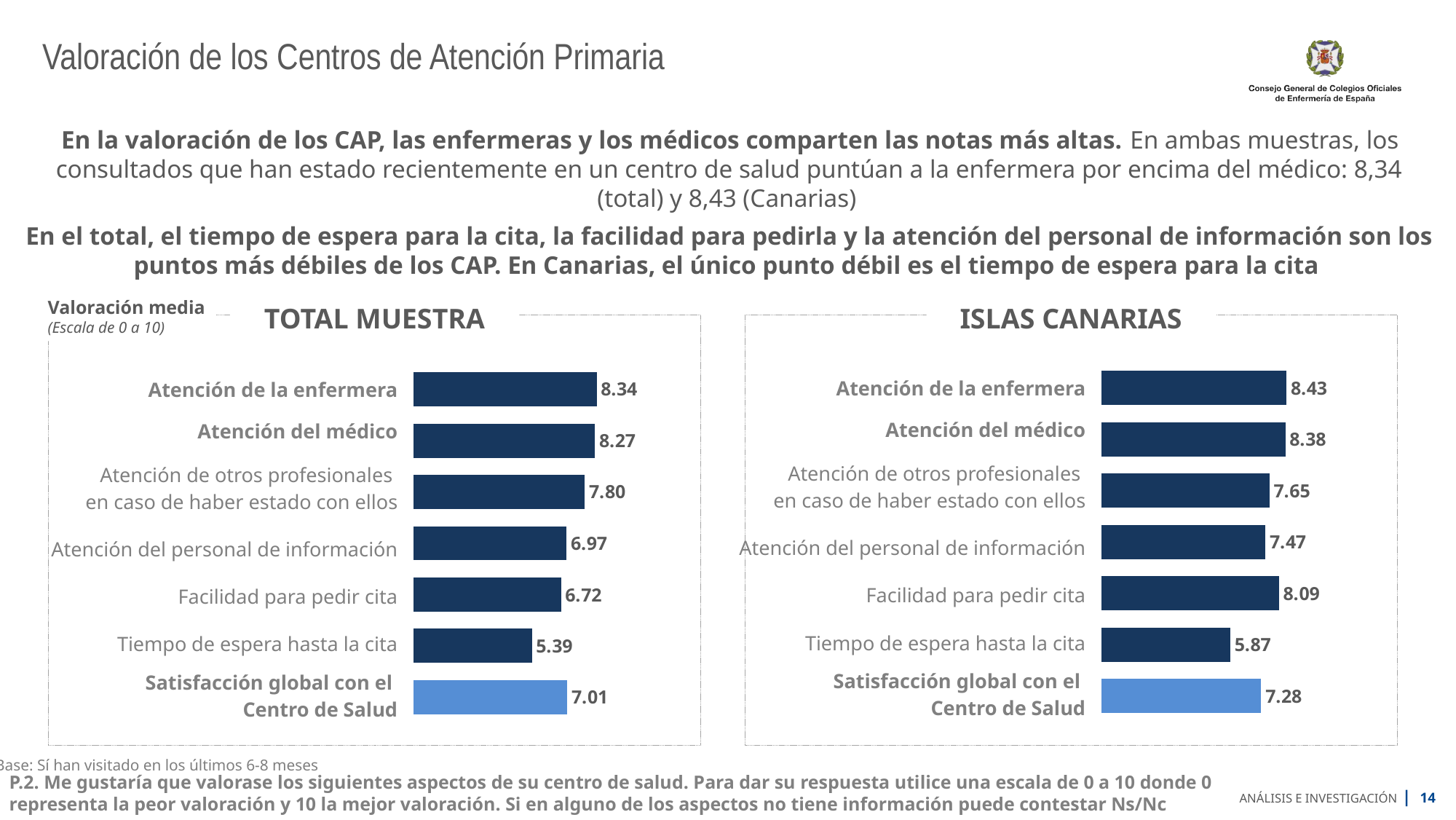
In the ISLAS CANARIAS chart, what is the value for Facilidad para pedir cita? 8.09 In the TOTAL MUESTRA chart, which category has the highest value? Atención de la enfermera How many categories are shown in the TOTAL MUESTRA chart? 7 In the TOTAL MUESTRA chart, what is the value for Satisfacción global con el Centro de Salud? 7.01 In the TOTAL MUESTRA chart, which is larger: Atención del personal de información or Facilidad para pedir cita? Atención del personal de información In the TOTAL MUESTRA chart, what is the value for Atención de la enfermera? 8.34 In the TOTAL MUESTRA chart, what is the difference between Atención del médico and Facilidad para pedir cita? 1.55 What kind of chart is the ISLAS CANARIAS chart? Bar chart In the ISLAS CANARIAS chart, which bar is shown in a lighter blue colour than the others? Satisfacción global con el Centro de Salud In the ISLAS CANARIAS chart, which is larger: Facilidad para pedir cita or Atención de otros profesionales en caso de haber estado con ellos? Facilidad para pedir cita In the ISLAS CANARIAS chart, what is the difference between Atención de la enfermera and Tiempo de espera hasta la cita? 2.56 In the ISLAS CANARIAS chart, which category has the lowest value? Tiempo de espera hasta la cita